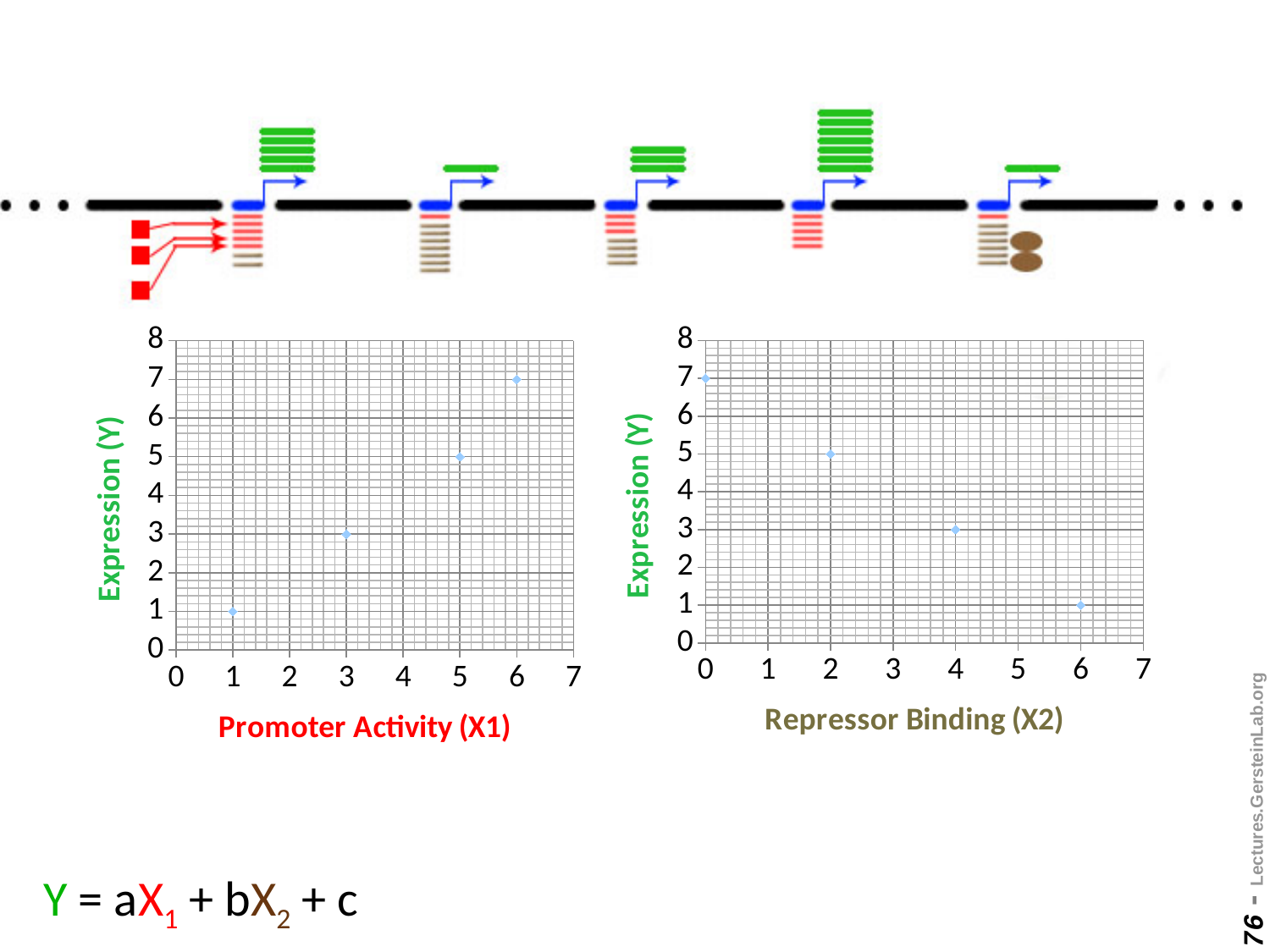
On the right chart (Repressor Binding (X2)), what is the difference in Expression (Y) between Repressor Binding 0 and Repressor Binding 6? 6 On the left chart (Promoter Activity (X1)), does Expression (Y) rise or fall as Promoter Activity increases? rise How many data points are plotted on the right chart (Repressor Binding (X2))? 4 What is the y-axis label on the right chart (Repressor Binding (X2))? Expression (Y) How many data points are plotted on the left chart (Promoter Activity (X1))? 4 On the right chart (Repressor Binding (X2)), does Expression (Y) rise or fall as Repressor Binding increases? fall What kind of chart is the left chart with x axis 'Promoter Activity (X1)'? scatter chart On the left chart (Promoter Activity (X1)), what is the Expression (Y) value when Promoter Activity is 6? 7 On the left chart (Promoter Activity (X1)), what is the Expression (Y) value when Promoter Activity is 3? 3 On the right chart (Repressor Binding (X2)), what is the Expression (Y) value when Repressor Binding is 6? 1 On the right chart (Repressor Binding (X2)), what is the Expression (Y) value when Repressor Binding is 0? 7 On the left chart (Promoter Activity (X1)), which Promoter Activity value has the highest Expression (Y)? 6